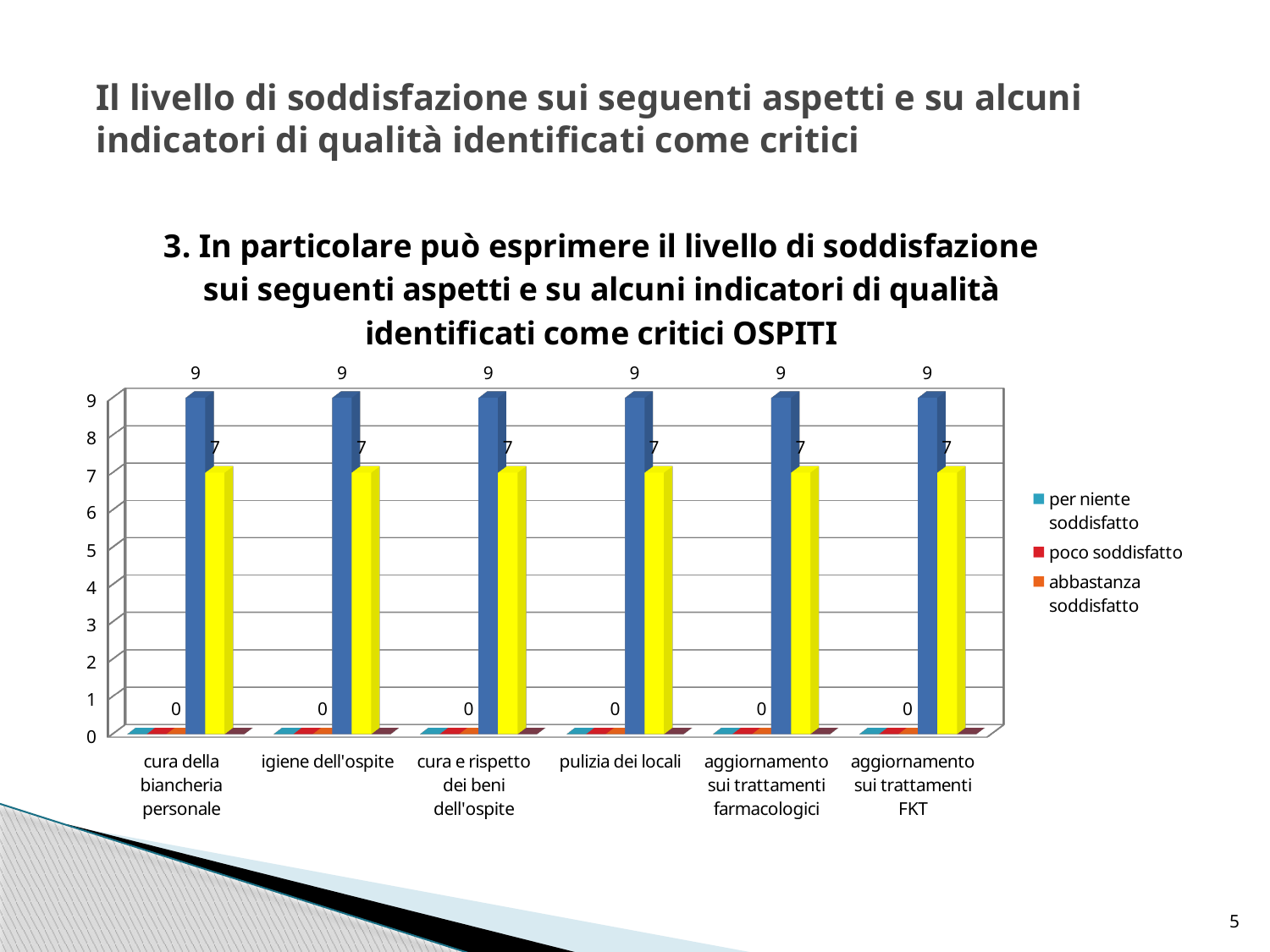
What is the value of the tallest (blue) bar for 'pulizia dei locali'? 9 What value is labelled on the small bars at the base of each category, for example 'cura della biancheria personale'? 0 Is the value of the yellow bar for 'cura e rispetto dei beni dell'ospite' greater or less than 5? greater What is the highest tick value shown on the chart's vertical axis? 9 What kind of chart is shown on the slide? bar chart Do the values of the tallest bars rise, fall, or stay the same across the categories from left to right? stay the same What is the value of the yellow bar for 'igiene dell'ospite'? 7 How many categories are shown along the x axis of the chart? 6 How many series does the chart's legend list? 3 For 'aggiornamento sui trattamenti FKT', which is taller: the blue bar or the yellow bar? the blue bar What is the first entry listed in the chart's legend? per niente soddisfatto What is the difference between the blue bar (9) and the yellow bar (7) for 'cura della biancheria personale'? 2